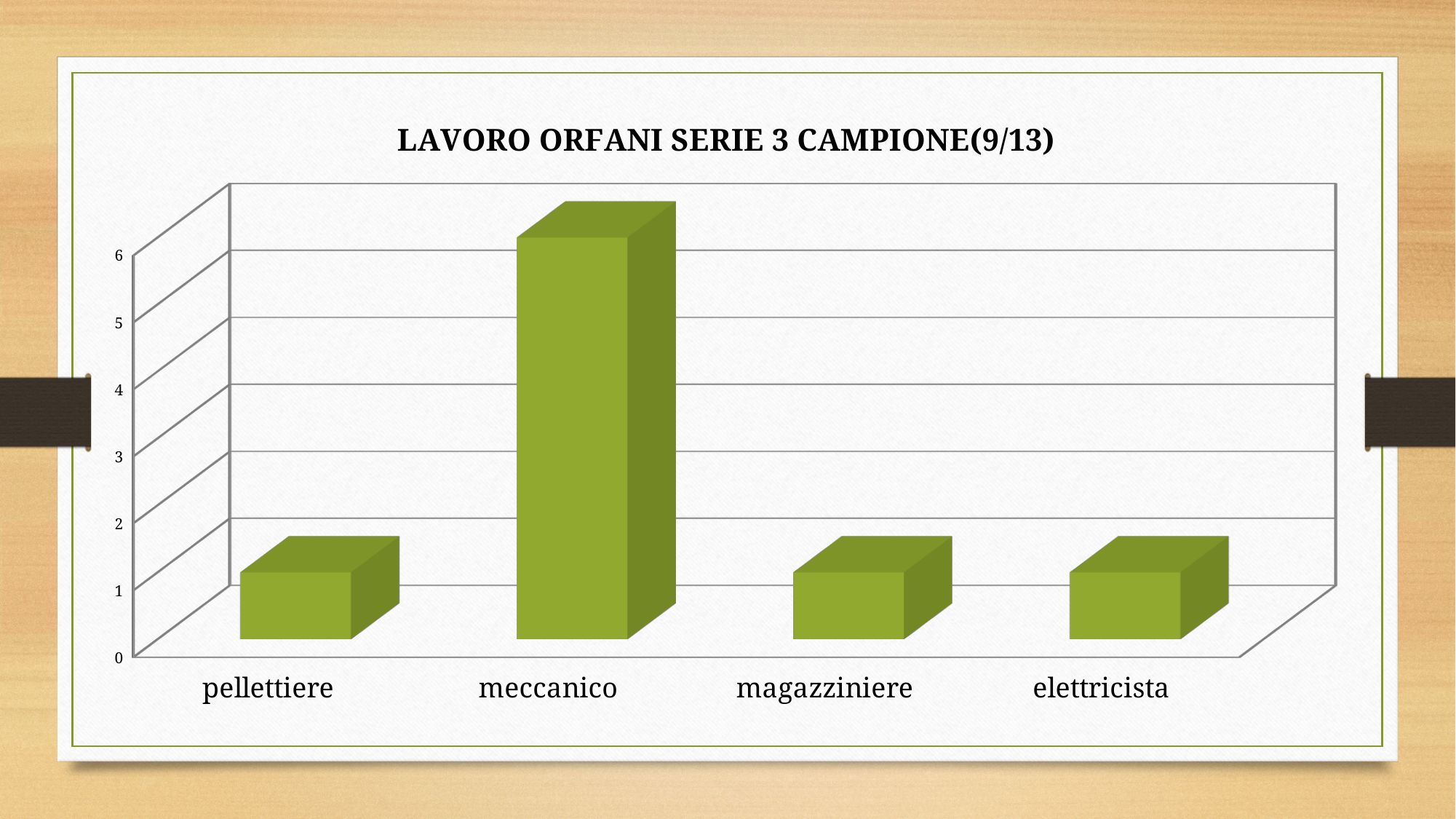
Is the value for magazziniere greater or less than 3? less Is the value for meccanico greater or less than 5? greater Which is larger, the value for meccanico or the value for pellettiere? meccanico Which category has the highest bar in the chart? meccanico Is the value for elettricista greater or less than 2? less What is the highest value shown on the vertical axis of the chart? 6 Which is larger, the value for meccanico or the value for elettricista? meccanico How many categories are shown on the x axis of the chart? 4 What is the title of the chart? LAVORO ORFANI SERIE 3 CAMPIONE(9/13) What kind of chart is shown on the slide? bar chart